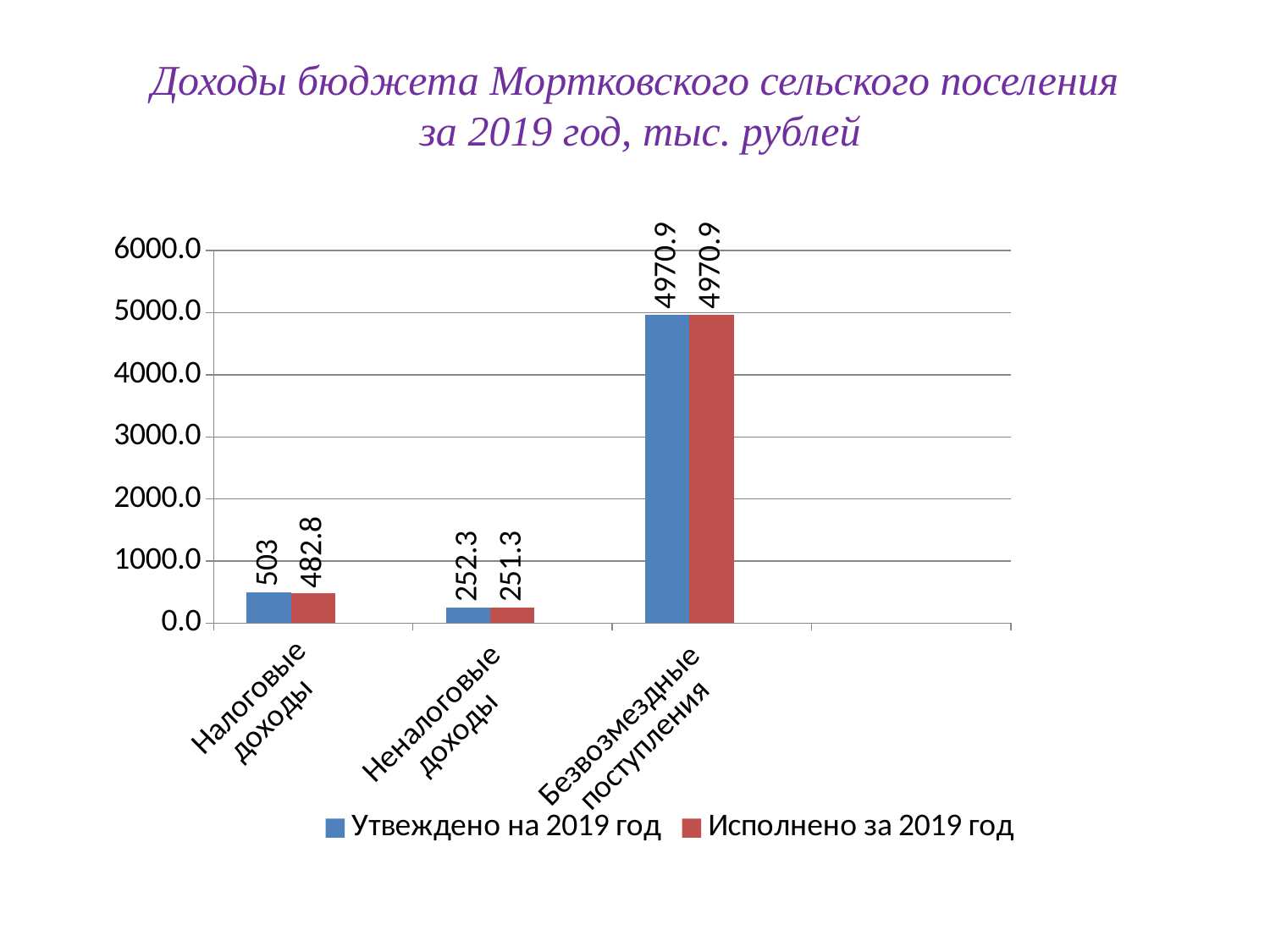
What is the value for Безвозмездные поступления in the series Исполнено за 2019 год? 4970.9 Is the value for Безвозмездные поступления in the series Утвеждено на 2019 год greater or less than 4000.0? greater What is the value for Налоговые доходы in the series Утвеждено на 2019 год? 503 What is the difference between the Утвеждено на 2019 год and Исполнено за 2019 год values for Налоговые доходы? 20.2 What is the value for Налоговые доходы in the series Исполнено за 2019 год? 482.8 How many series does the legend list? 2 How many categories are shown on the x axis? 3 For Неналоговые доходы, which series has the larger value: Утвеждено на 2019 год or Исполнено за 2019 год? Утвеждено на 2019 год Which category has the highest value in the series Исполнено за 2019 год? Безвозмездные поступления Which category has the lowest value in the series Утвеждено на 2019 год? Неналоговые доходы What kind of chart is shown on the slide? bar chart What is the value for Неналоговые доходы in the series Утвеждено на 2019 год? 252.3